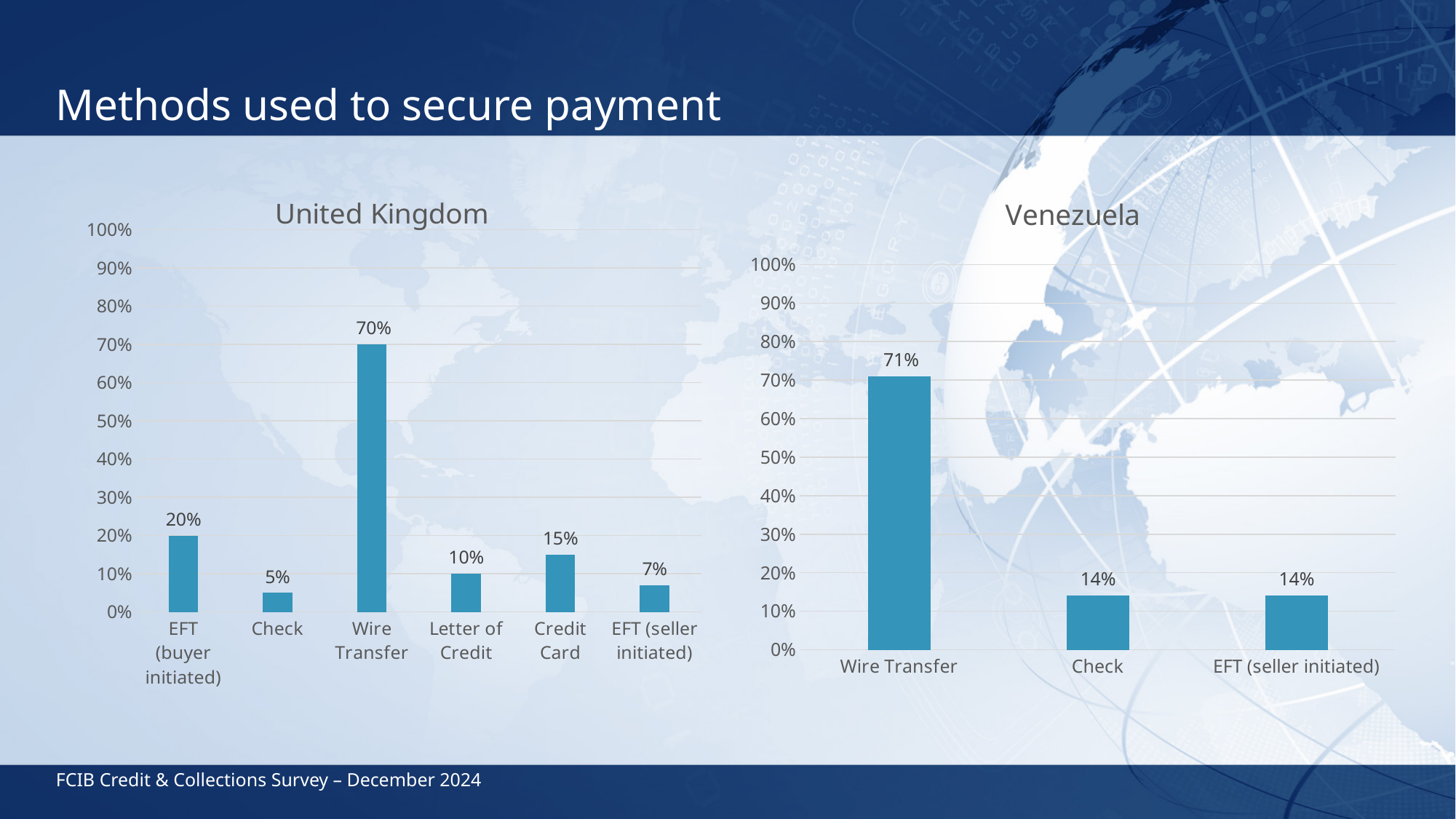
How many categories are shown in the United Kingdom chart? 6 In the United Kingdom chart, which category has the lowest value? Check In the United Kingdom chart, which is larger: Letter of Credit or EFT (seller initiated)? Letter of Credit In the Venezuela chart, which category has the highest value? Wire Transfer In the Venezuela chart, what is the difference between Wire Transfer and Check? 57% What kind of chart is the Venezuela chart? Bar chart How many categories are shown in the Venezuela chart? 3 In the United Kingdom chart, what is the value for Check? 5% In the United Kingdom chart, what is the difference between EFT (buyer initiated) and Credit Card? 5% In the Venezuela chart, what is the value for Wire Transfer? 71% In the United Kingdom chart, what is the value for Wire Transfer? 70% What is the title of the chart on the left side of the slide? United Kingdom